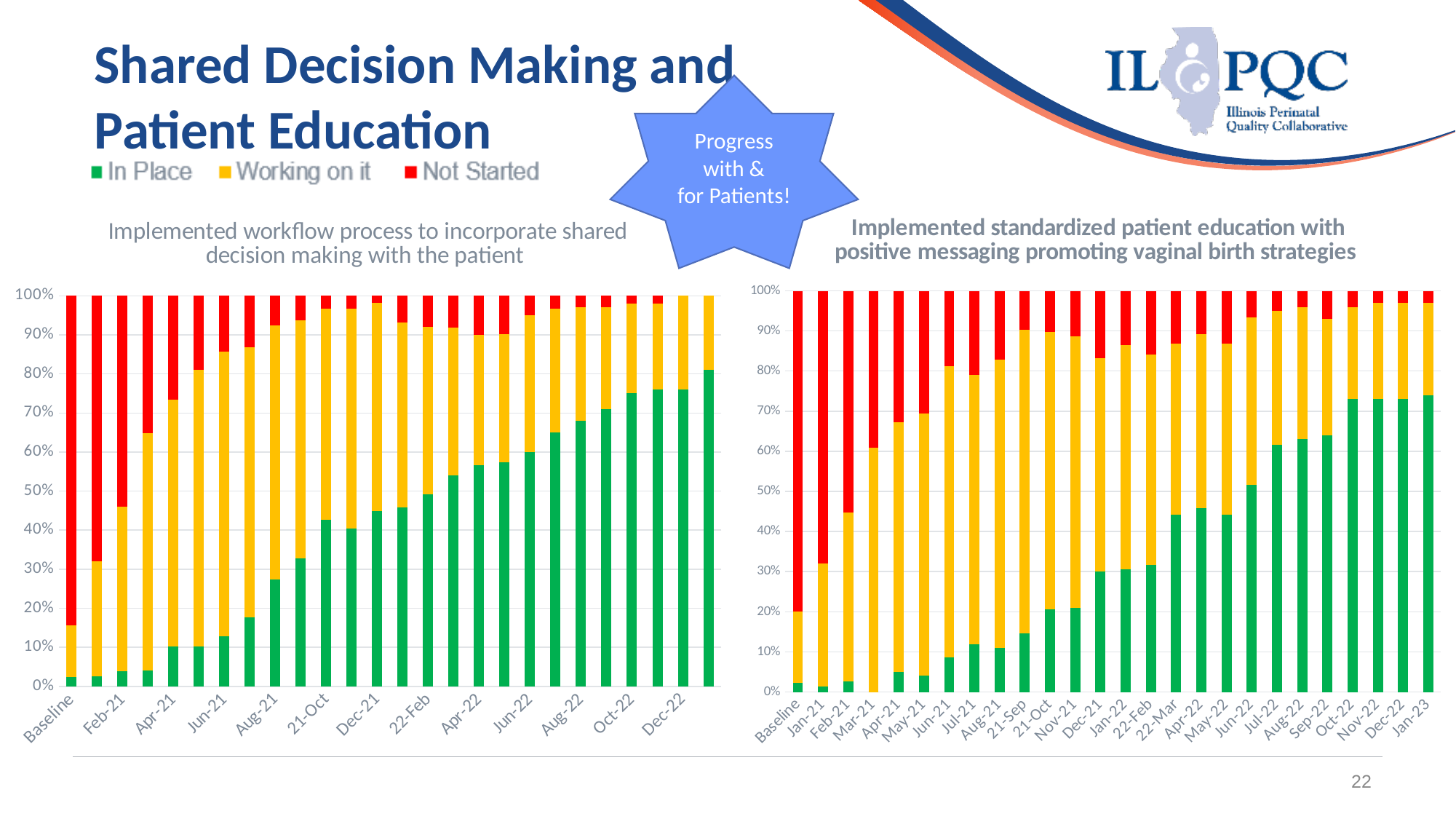
In the left chart, 'Implemented workflow process...', is the In Place value for Baseline greater or less than 10%? less In the right chart, 'Implemented standardized patient education with positive messaging promoting vaginal birth strategies', how many time-period categories are shown on the x axis? 26 How many series does the legend list for the charts on this slide? 3 In the right chart, 'Implemented standardized patient education...', is the Not Started value for Baseline greater or less than 70%? greater Which colour represents the 'Not Started' series in the charts? Red In the left chart, 'Implemented workflow process...', is the In Place value for Dec-22 greater or less than 70%? greater What kind of chart is the left chart, 'Implemented workflow process to incorporate shared decision making with the patient'? Stacked bar chart In the left chart, 'Implemented workflow process...', does the In Place share generally rise or fall from Baseline to Dec-22? Rise In the right chart, 'Implemented standardized patient education...', which is larger: the Not Started value at Baseline or at Jan-23? Baseline